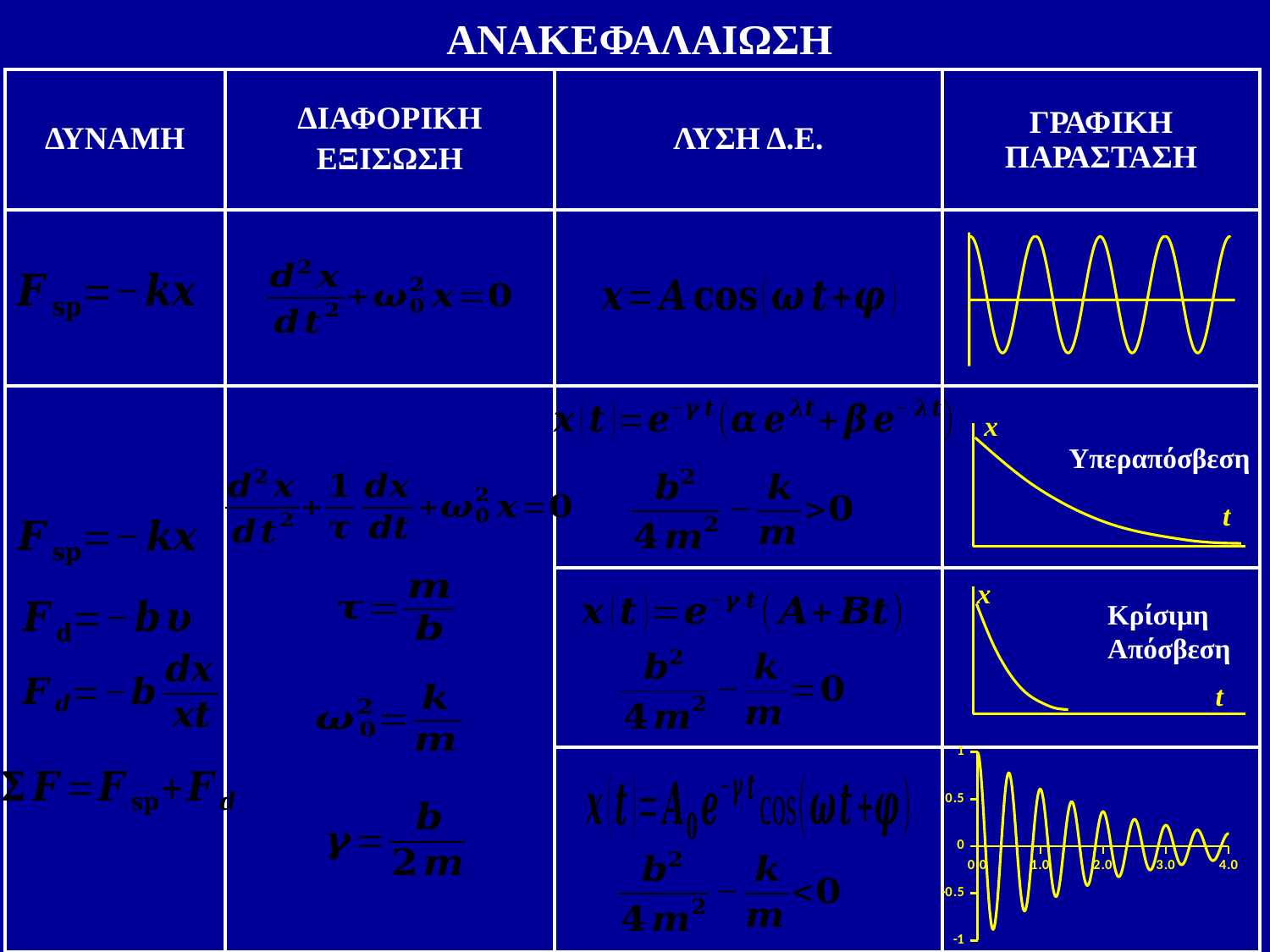
In the bottom-right graph, does the amplitude of the oscillation increase or decrease as the horizontal axis value increases? decrease What kind of chart is the graph in the bottom-right cell of the table? line chart What is the highest tick value on the vertical axis of the bottom-right graph? 1 How many graphs are shown in the ΓΡΑΦΙΚΗ ΠΑΡΑΣΤΑΣΗ column of the table? 4 In the graph labelled Υπεραπόσβεση, does x rise or fall as t increases? fall In the graph labelled Κρίσιμη Απόσβεση, does x rise or fall as t increases? fall What is the lowest tick value on the vertical axis of the bottom-right graph? -1 What colour are the curves drawn in the graphs on the slide? yellow What is the text label shown next to the second graph in the right column? Υπεραπόσβεση What is the largest tick value on the horizontal axis of the bottom-right graph? 4.0